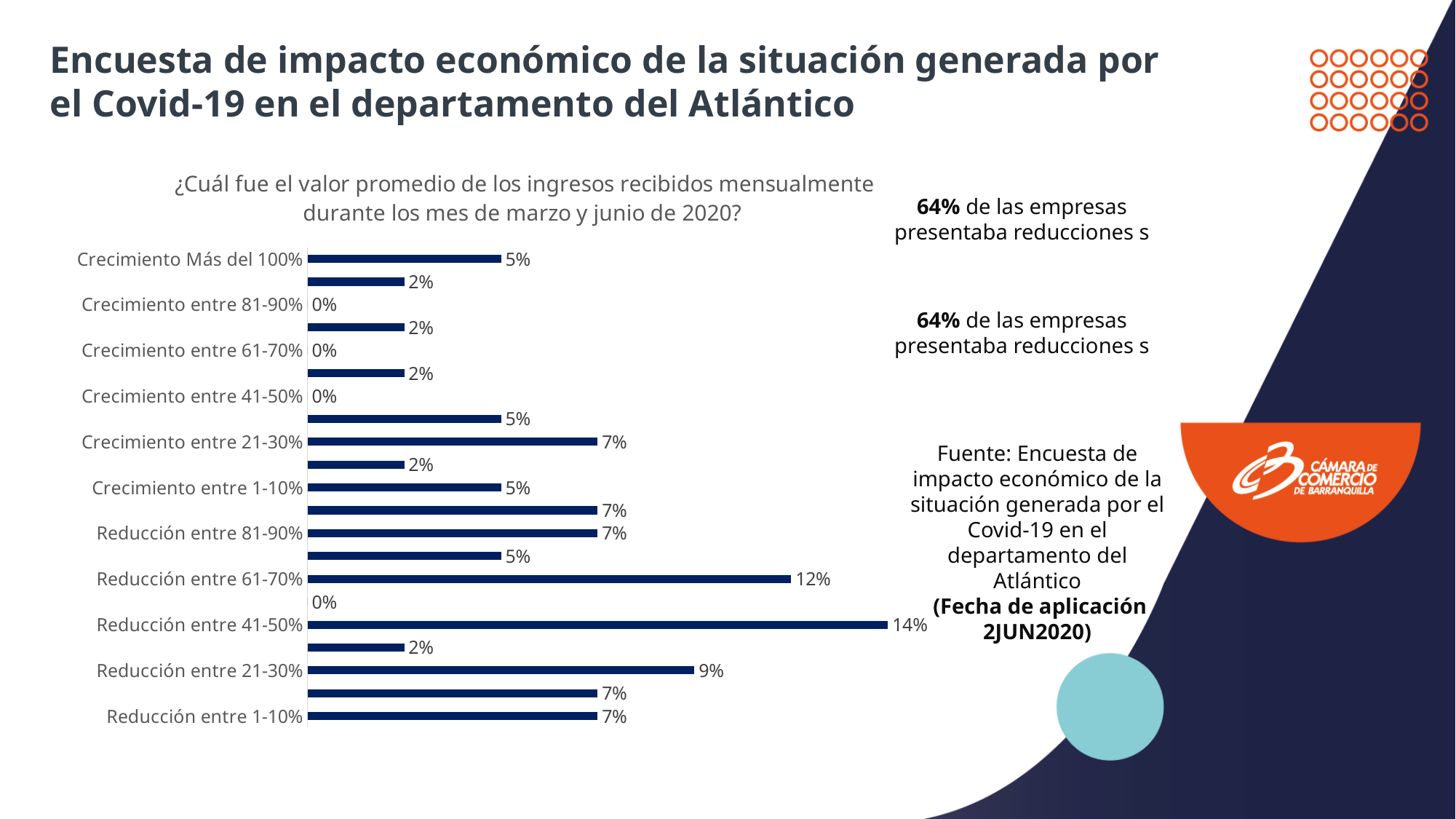
What is the value for "Crecimiento Más del 100%"? 5% Which labeled category has the highest value? Reducción entre 41-50% What is the value for "Reducción entre 41-50%"? 14% How many bars are plotted in the chart? 21 What is the value for "Crecimiento entre 81-90%"? 0% What is the value for "Reducción entre 21-30%"? 9% What question does the chart title ask? ¿Cuál fue el valor promedio de los ingresos recibidos mensualmente durante los mes de marzo y junio de 2020? Which is larger, the value for "Reducción entre 21-30%" or the value for "Crecimiento entre 21-30%"? Reducción entre 21-30% What is the difference between the values for "Reducción entre 41-50%" and "Reducción entre 61-70%"? 2% What is the value for "Reducción entre 1-10%"? 7% What is the value for "Reducción entre 61-70%"? 12% What kind of chart is shown on the slide? bar chart